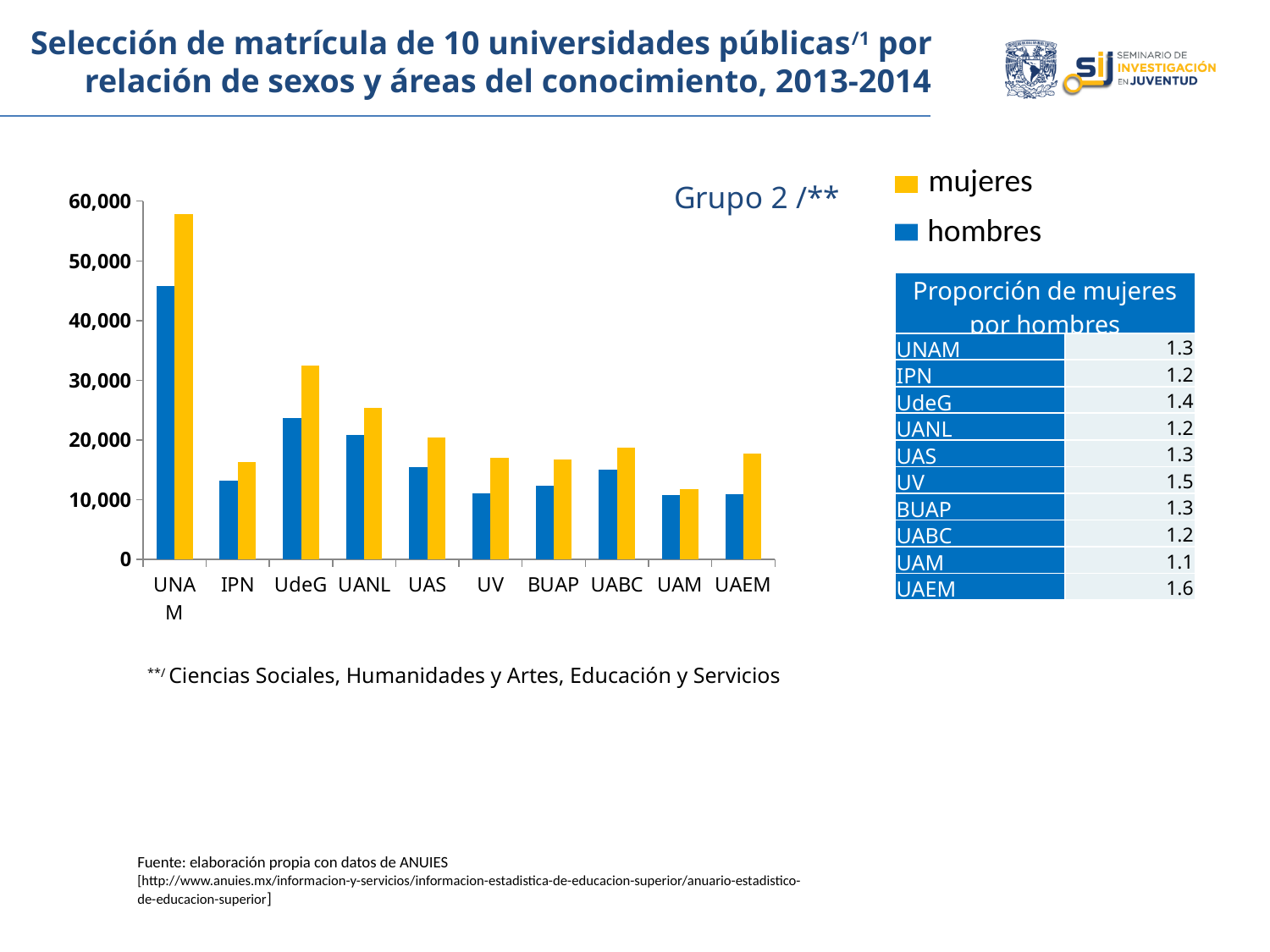
Is the value for hombres at UdeG greater or less than 30,000? less How many universities are shown on the x axis of the chart? 10 Which university has the highest value for mujeres? UNAM Is the value for mujeres at UdeG greater or less than 30,000? greater Which is larger, the mujeres value for UdeG or the mujeres value for UANL? UdeG Which university has the lowest value for mujeres? UAM Which colour represents mujeres in the chart legend? yellow Which university has the highest value for hombres? UNAM Is the value for mujeres at UNAM greater or less than 50,000? greater How many series does the chart legend list? 2 What kind of chart is shown on the slide? bar chart